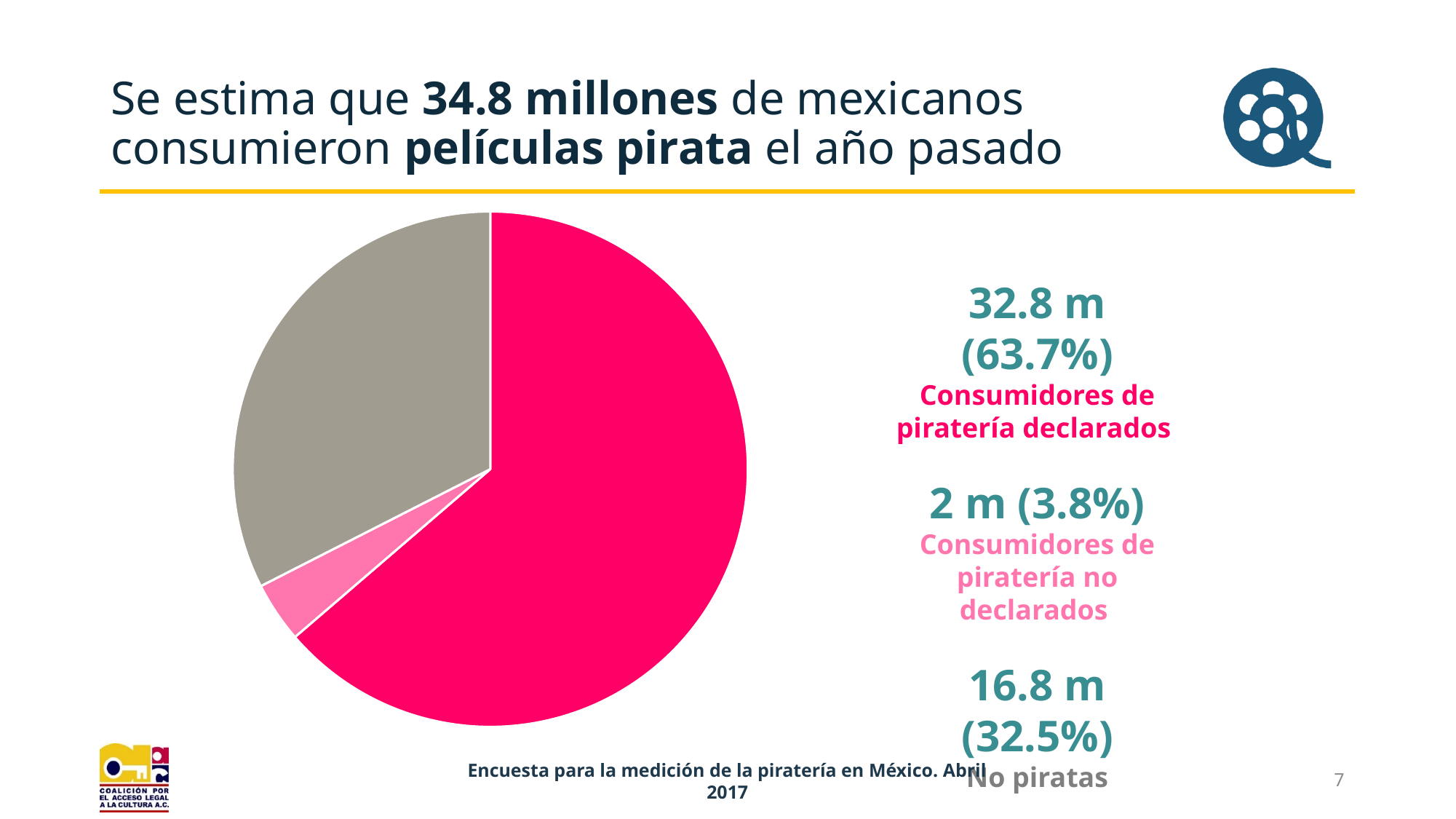
Which category has the smallest slice of the pie? Consumidores de piratería no declarados What share of the pie corresponds to 'Consumidores de piratería declarados'? 63.7% Which is larger, the slice for 'No piratas' or the slice for 'Consumidores de piratería no declarados'? No piratas How many millions of people are 'No piratas'? 16.8 m What colour is the slice for 'No piratas'? Grey How many slices does the pie chart have? 3 Which category has the largest slice of the pie? Consumidores de piratería declarados How many millions of people are 'Consumidores de piratería no declarados'? 2 m What share of the pie corresponds to 'Consumidores de piratería no declarados'? 3.8% What kind of chart is shown on the slide? Pie chart How many millions of people are 'Consumidores de piratería declarados'? 32.8 m What share of the pie corresponds to 'No piratas'? 32.5%